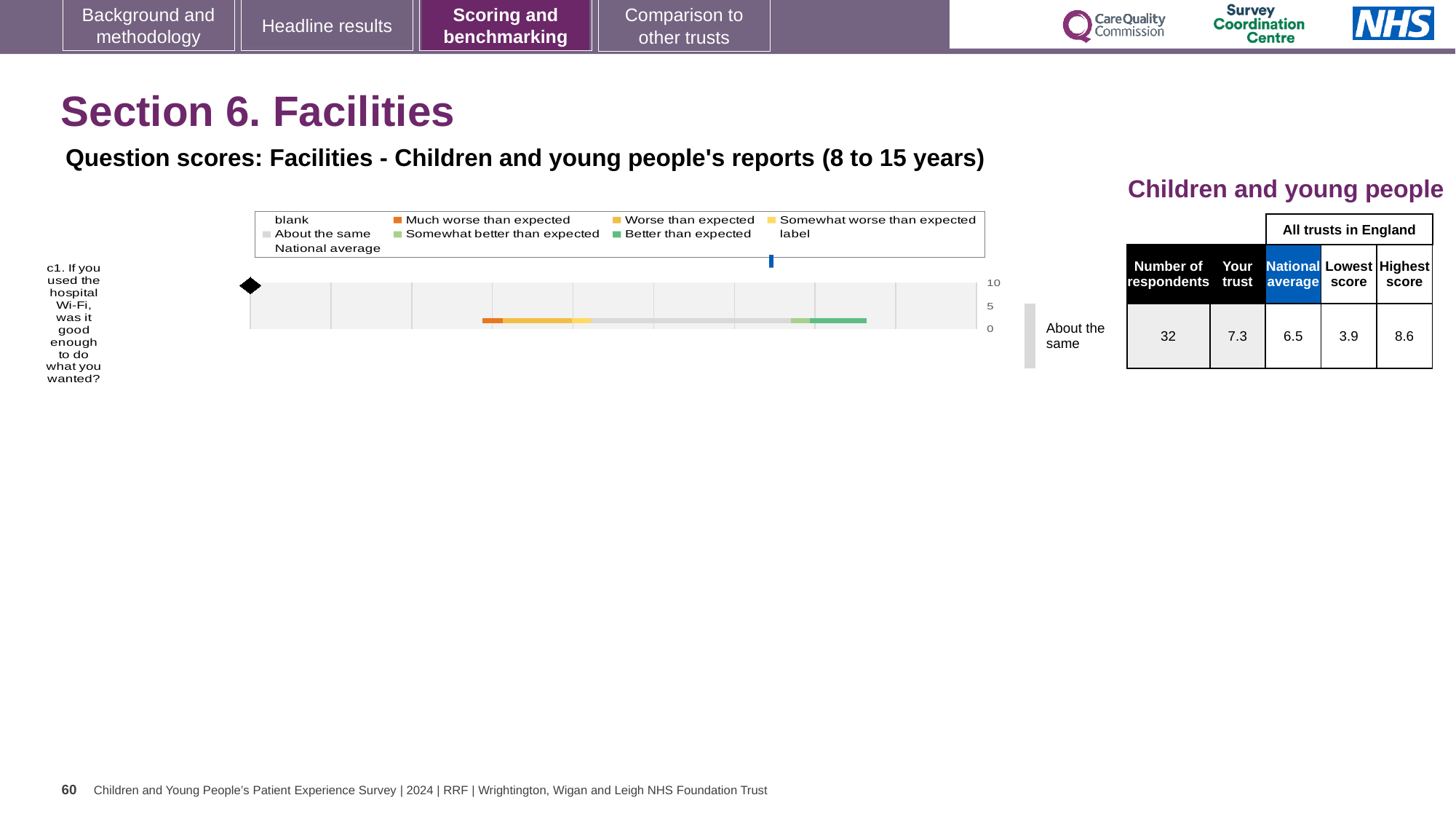
What is the difference between the highest score and the lowest score for question c1? 4.7 In the table beside the chart, what is the lowest score among all trusts in England for question c1? 3.9 What kind of chart is shown for question c1 about the hospital Wi-Fi? bar chart Which benchmark category is shown for question c1 (hospital Wi-Fi)? About the same What is the highest value shown on the chart's score axis? 10 In the table beside the chart, what is the 'Your trust' score for question c1? 7.3 Is the 'Your trust' score for question c1 greater or less than 5? greater How many survey questions are plotted in the chart? 1 In the table beside the chart, what is the national average score for question c1? 6.5 How many respondents answered question c1 about the hospital Wi-Fi? 32 Which is larger for question c1: the 'Your trust' score or the national average? Your trust In the table beside the chart, what is the highest score among all trusts in England for question c1? 8.6